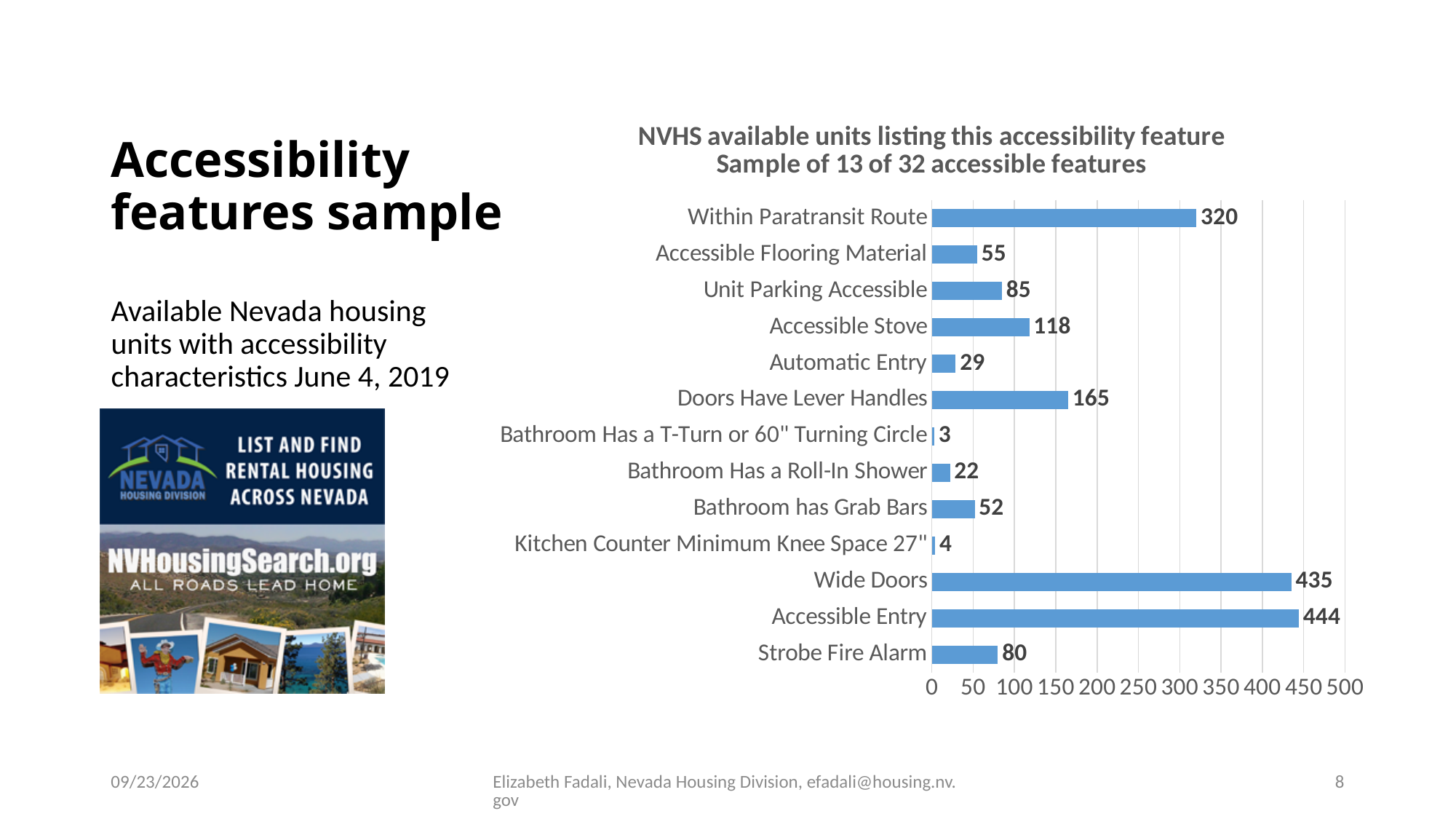
What is the difference between the values for Unit Parking Accessible and Accessible Flooring Material? 30 What is the title of the chart? NVHS available units listing this accessibility feature Sample of 13 of 32 accessible features Which category has the highest value? Accessible Entry What is the difference between the values for Accessible Entry and Wide Doors? 9 What kind of chart is shown on the slide? bar chart Which is larger, the value for Strobe Fire Alarm or the value for Bathroom has Grab Bars? Strobe Fire Alarm Which category has the lowest value? Bathroom Has a T-Turn or 60" Turning Circle Is the value for Within Paratransit Route greater or less than 300? greater What is the value for Accessible Stove? 118 What is the value for Within Paratransit Route? 320 How many categories are shown in the chart? 13 What is the value for Doors Have Lever Handles? 165